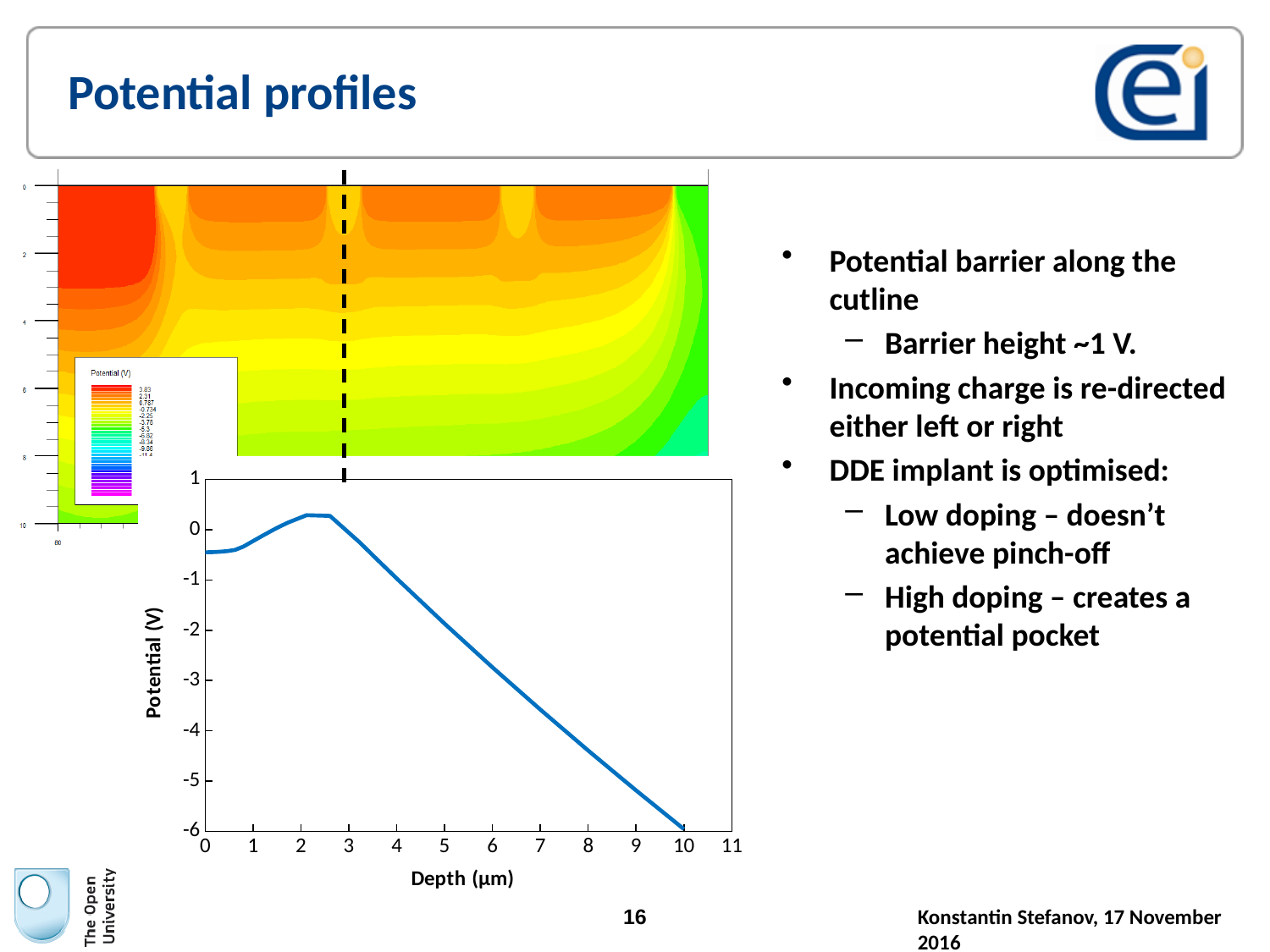
In the Potential vs Depth line chart, is the potential at a depth of 0 µm greater or less than 0 V? less In the Potential vs Depth line chart, is the potential higher at a depth of 2 µm or at a depth of 8 µm? 2 µm In the Potential vs Depth line chart, is the potential at a depth of 8 µm greater or less than -3 V? less In the Potential vs Depth line chart, does the potential rise or fall as depth increases from 3 µm to 10 µm? fall In the Potential vs Depth line chart, what is the lowest value shown on the y axis? -6 What kind of chart is the lower-left chart with Depth on the x axis? line chart In the Potential vs Depth line chart, what is the label of the x axis? Depth (µm) In the Potential vs Depth line chart, is the potential at a depth of 5 µm greater or less than -3 V? greater In the Potential vs Depth line chart, how many lines (series) are plotted? 1 In the Potential vs Depth line chart, what is the label of the y axis? Potential (V)